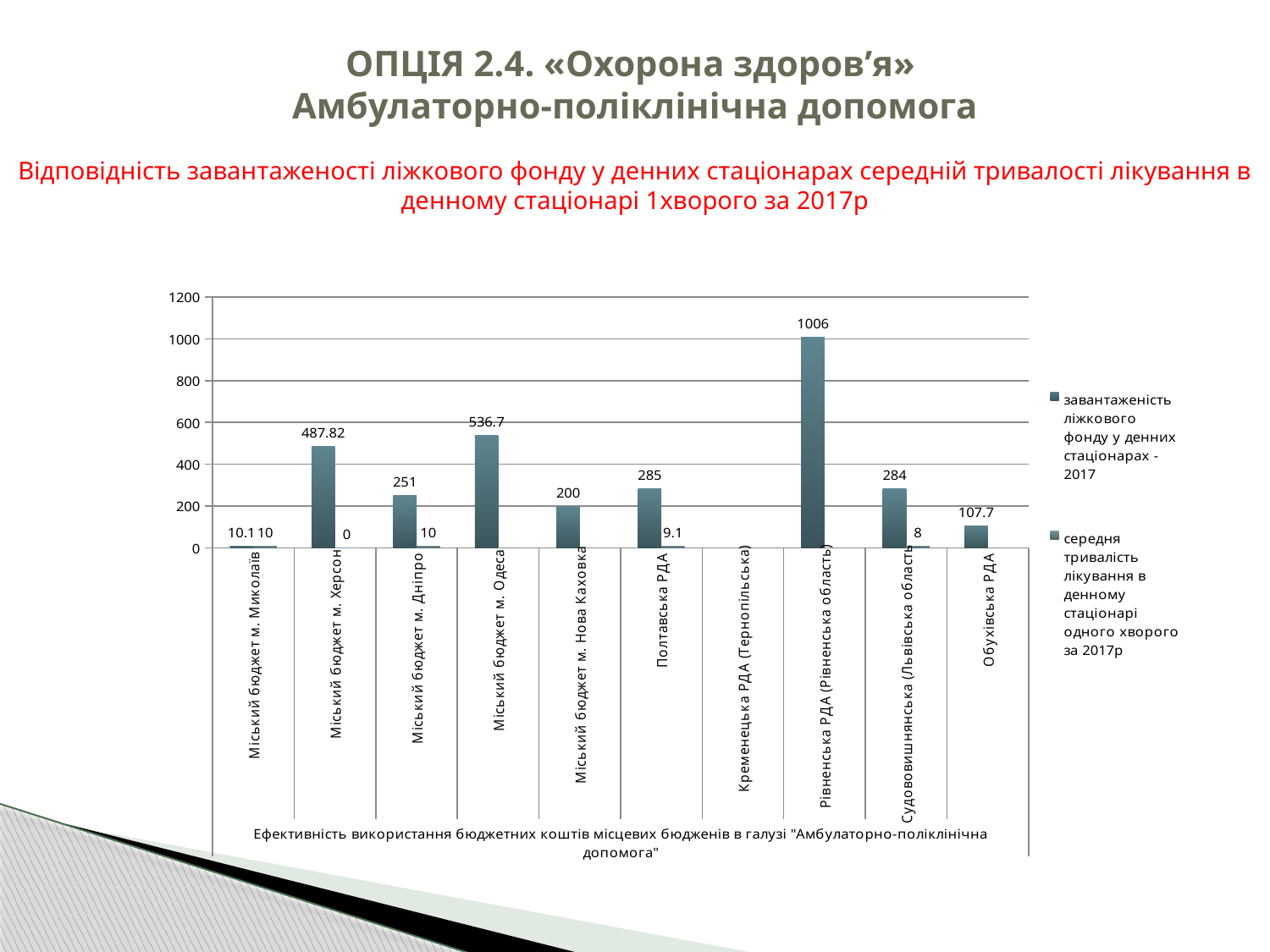
What kind of chart is shown on the slide? Bar chart Is the завантаженість ліжкового фонду value for Обухівська РДА greater or less than 200? less What is the difference between the завантаженість ліжкового фонду values for Рівненська РДА (Рівненська область) and Міський бюджет м. Одеса? 469.3 What is the value of завантаженість ліжкового фонду у денних стаціонарах - 2017 for Міський бюджет м. Херсон? 487.82 How many series does the legend list? 2 What is the value of завантаженість ліжкового фонду у денних стаціонарах - 2017 for Рівненська РДА (Рівненська область)? 1006 How many categories are shown on the x axis of the chart? 10 Which category has the highest value for завантаженість ліжкового фонду у денних стаціонарах - 2017? Рівненська РДА (Рівненська область) Which has a larger завантаженість ліжкового фонду value: Міський бюджет м. Дніпро or Міський бюджет м. Нова Каховка? Міський бюджет м. Дніпро What is the difference between the завантаженість ліжкового фонду values for Міський бюджет м. Одеса and Міський бюджет м. Херсон? 48.88 What is the value of завантаженість ліжкового фонду у денних стаціонарах - 2017 for Міський бюджет м. Одеса? 536.7 What is the value of середня тривалість лікування в денному стаціонарі одного хворого за 2017р for Полтавська РДА? 9.1